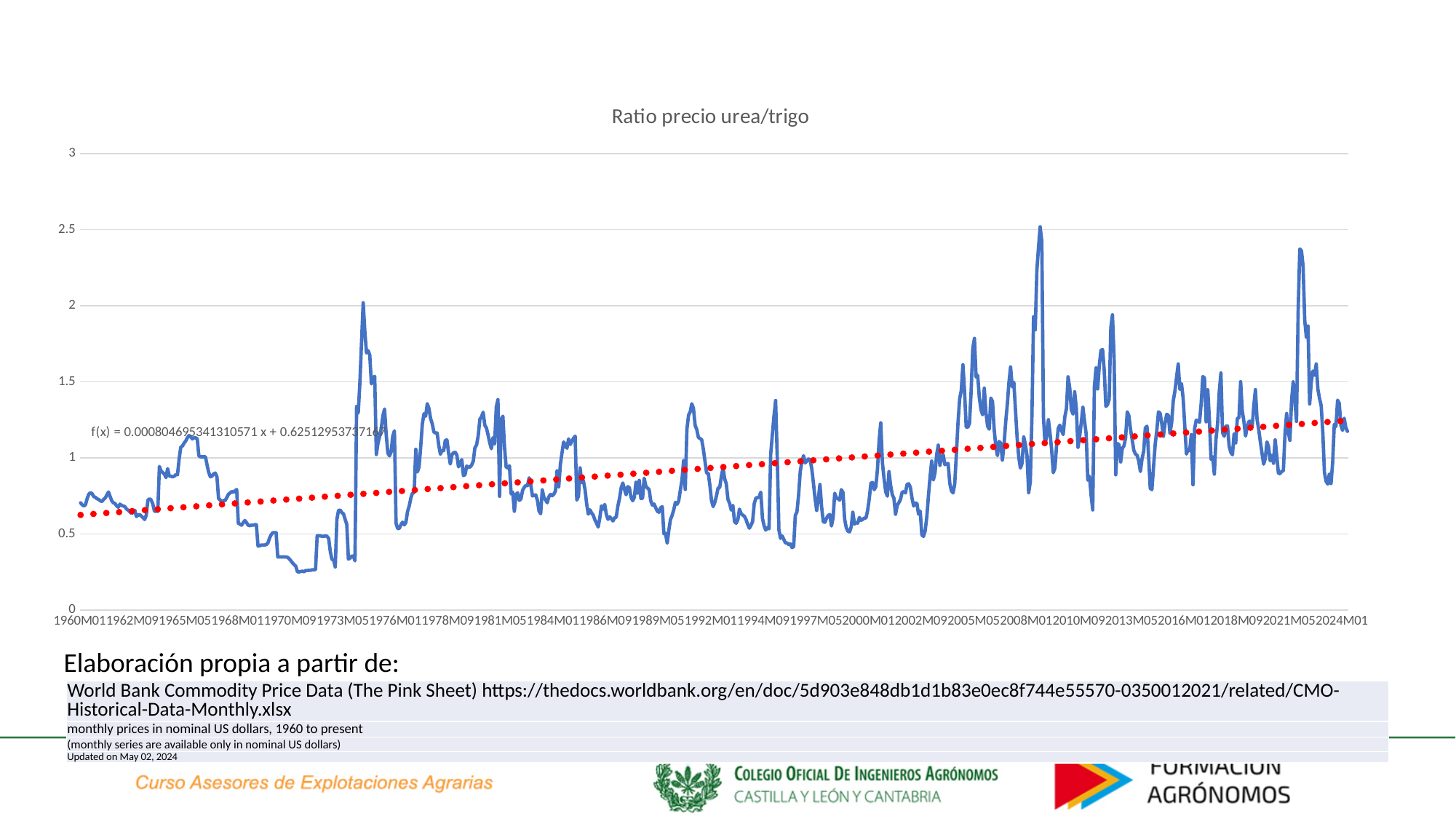
What is the first label on the horizontal axis of the chart? 1960M01 Does the red dotted trendline rise or fall from left to right across the chart? rise What is the highest value shown on the vertical axis of the chart? 3 Is the peak of the blue line near 2021-2022 greater or less than 2.5? less What is the slope coefficient (the number multiplying x) in the trendline equation printed on the chart? 0.000804695341310571 Is the highest peak of the blue line, around 2008, greater or less than 2? greater Is the value of the blue line at the start of the series in 1960 greater or less than 1? less Which is higher: the peak of the blue line around 1975 or the peak around 2008? the peak around 2008 What kind of chart is shown on the slide? line chart What is the title of the chart? Ratio precio urea/trigo